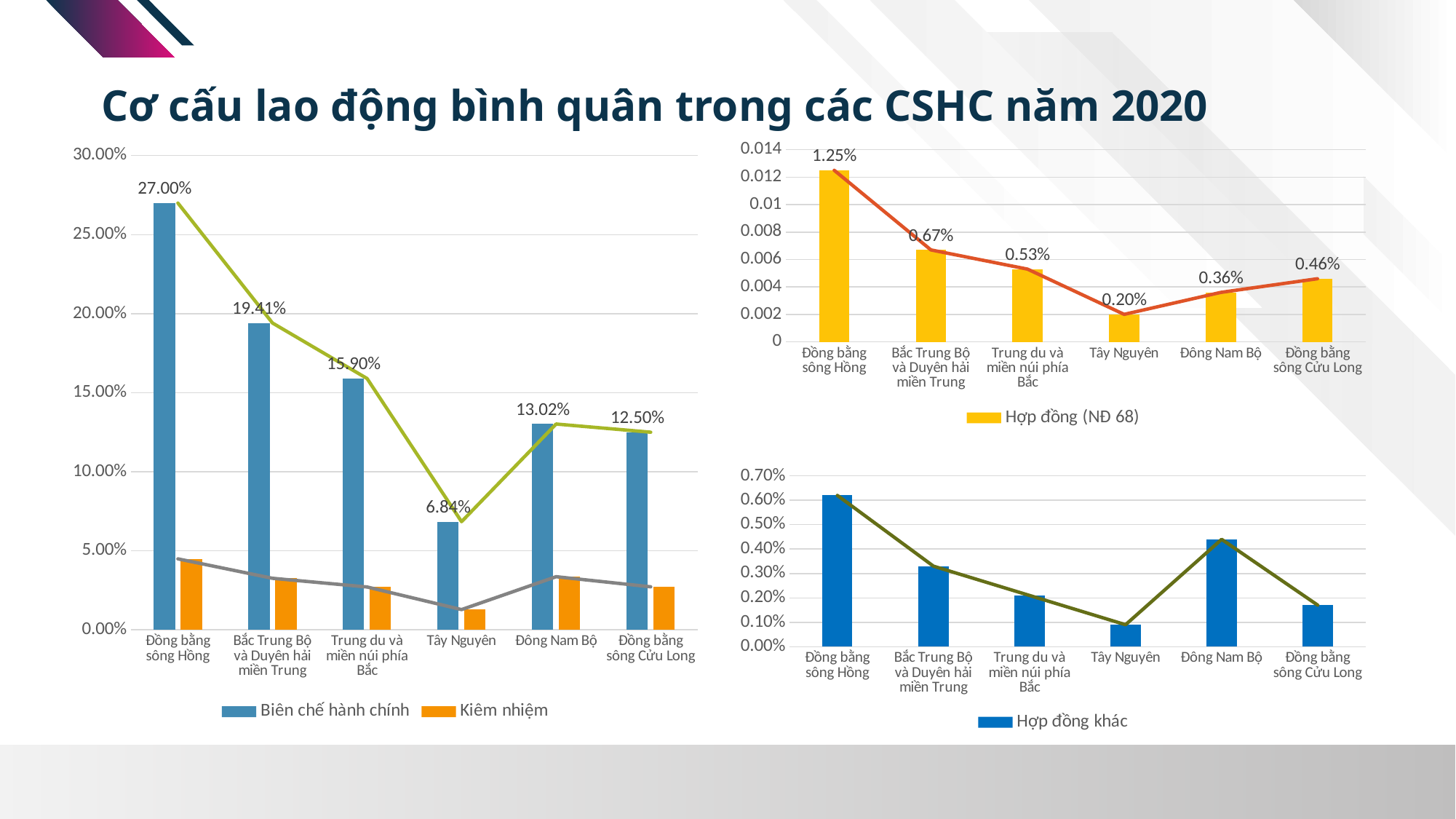
In the top-right chart (Hợp đồng (NĐ 68)), which region has the highest value? Đồng bằng sông Hồng In the left chart, what is the Biên chế hành chính value for Tây Nguyên? 6.84% How many regions are shown on the x axis of the bottom-right chart (Hợp đồng khác)? 6 In the left chart, what is the difference between the Biên chế hành chính values for Đồng bằng sông Hồng and Bắc Trung Bộ và Duyên hải miền Trung? 7.59% In the top-right chart (Hợp đồng (NĐ 68)), what is the difference between the values for Đồng bằng sông Cửu Long and Đông Nam Bộ? 0.10% In the bottom-right chart (Hợp đồng khác), is the value for Đồng bằng sông Hồng greater or less than 0.50%? greater In the top-right chart (Hợp đồng (NĐ 68)), what is the value for Trung du và miền núi phía Bắc? 0.53% In the left chart, what is the Biên chế hành chính value for Đồng bằng sông Hồng? 27.00% In the left chart, which region has the lowest Biên chế hành chính value? Tây Nguyên In the bottom-right chart (Hợp đồng khác), which region has the lowest value? Tây Nguyên How many series does the legend of the left chart list? 2 In the left chart, is the Biên chế hành chính value for Đông Nam Bộ larger than that for Đồng bằng sông Cửu Long? Yes, Đông Nam Bộ